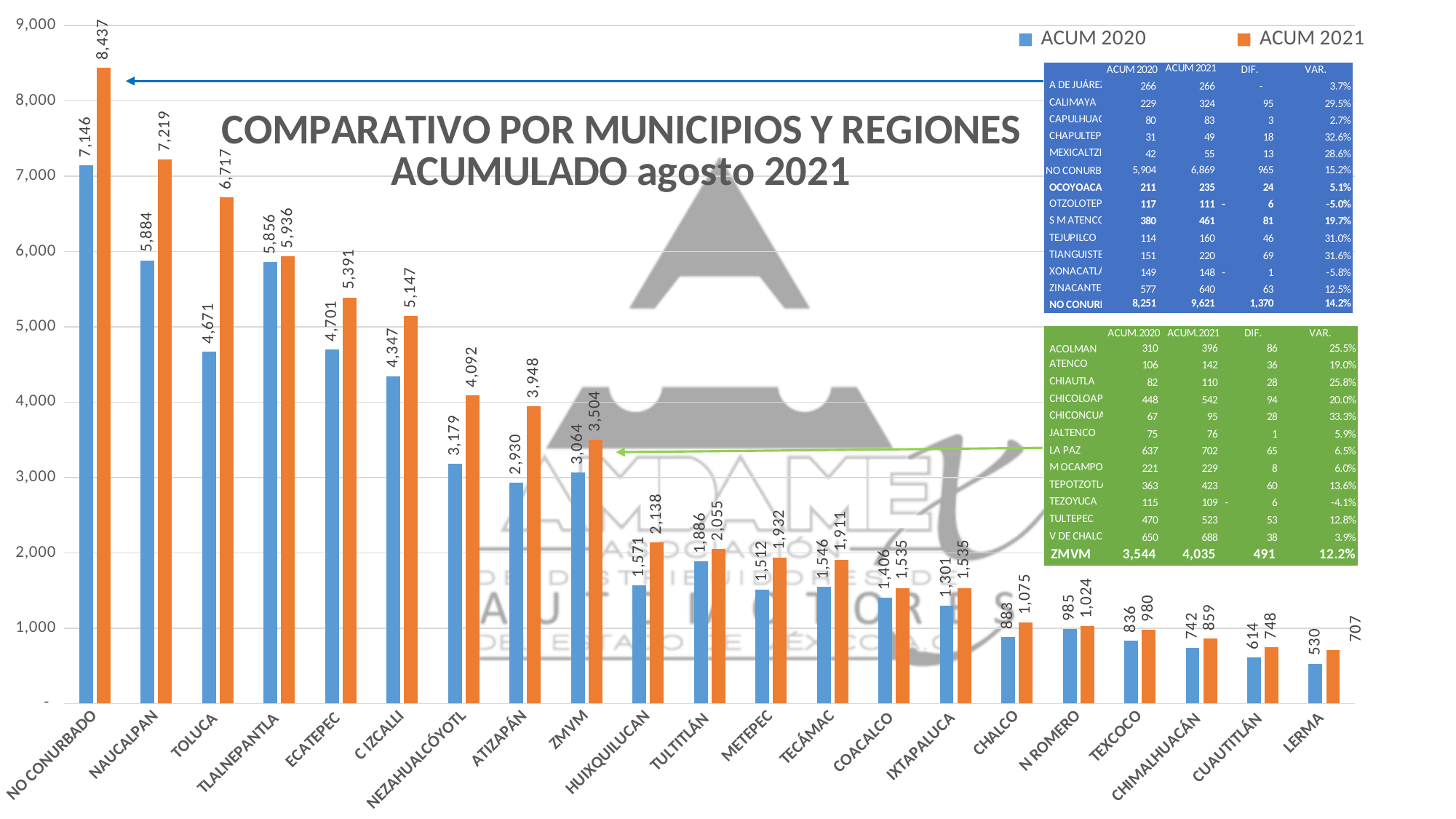
Which category has the highest ACUM 2021 value? NO CONURBADO Is the ACUM 2020 value for ECATEPEC greater or less than 5,000? less What is the ACUM 2021 value for NO CONURBADO? 8,437 What is the ACUM 2021 value for LERMA? 707 Which category has the lowest ACUM 2020 value? LERMA How many categories are shown on the x axis? 21 What is the difference between the ACUM 2021 and ACUM 2020 values for NAUCALPAN? 1,335 Do the ACUM 2021 values generally rise or fall from left to right along the x axis? fall What is the ACUM 2020 value for TOLUCA? 4,671 How many series does the legend list? 2 What kind of chart is shown on the slide? bar chart Which is larger for TLALNEPANTLA, the ACUM 2020 value or the ACUM 2021 value? ACUM 2021